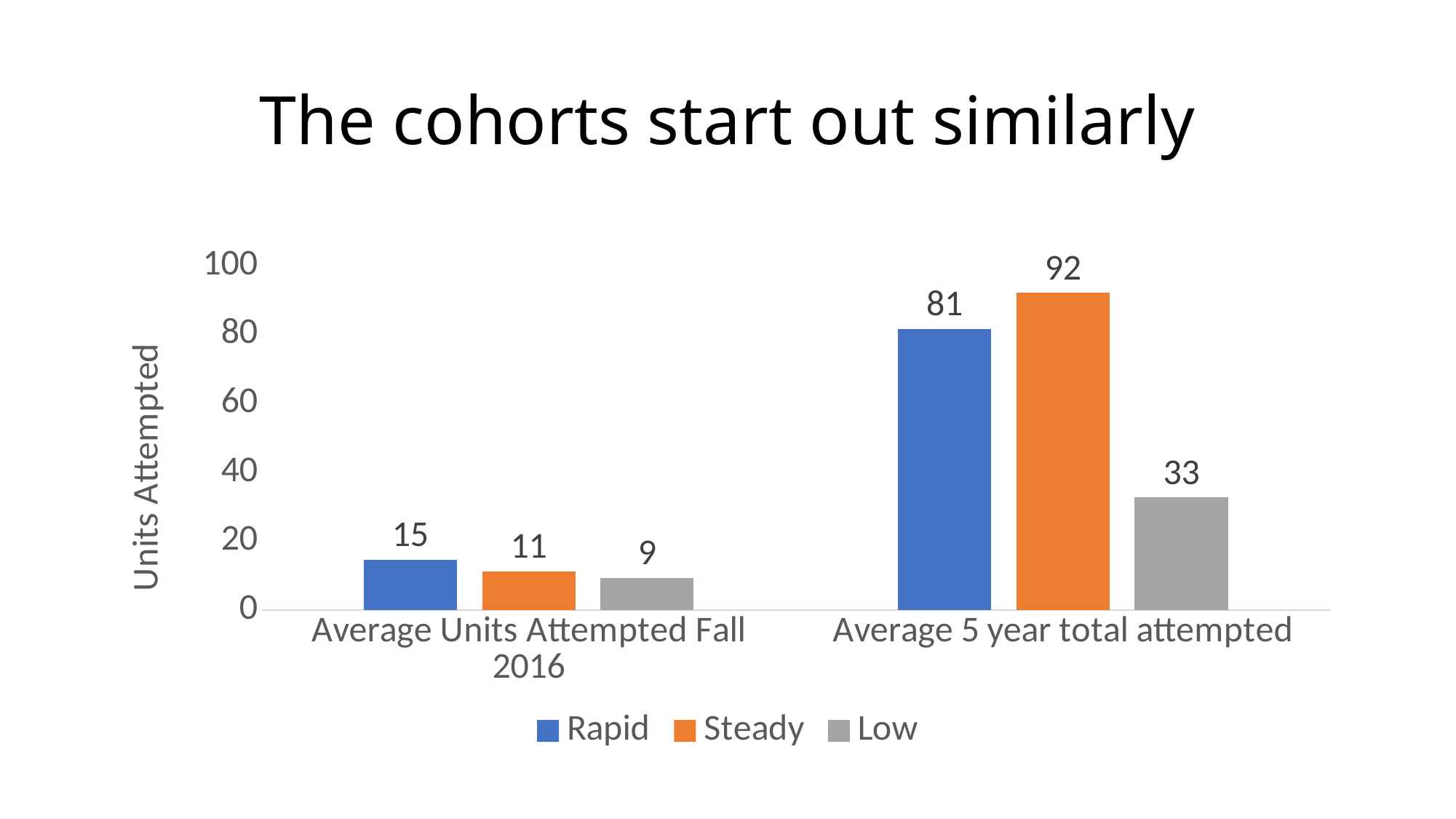
What is the difference between the Steady and Rapid values in the Average 5 year total attempted category? 11 What is the difference between the Rapid and Low values in the Average Units Attempted Fall 2016 category? 6 Is the value for Rapid in the Average 5 year total attempted category greater or less than 60? greater How many categories are shown on the x axis? 2 Which series has the highest value in the Average 5 year total attempted category? Steady What is the value for Rapid in the Average Units Attempted Fall 2016 category? 15 Which is larger: the Rapid value or the Steady value in the Average Units Attempted Fall 2016 category? Rapid What kind of chart is shown on the slide? bar chart What is the value for Steady in the Average 5 year total attempted category? 92 What is the value for Low in the Average 5 year total attempted category? 33 How many series does the legend list? 3 Which series has the lowest value in the Average Units Attempted Fall 2016 category? Low